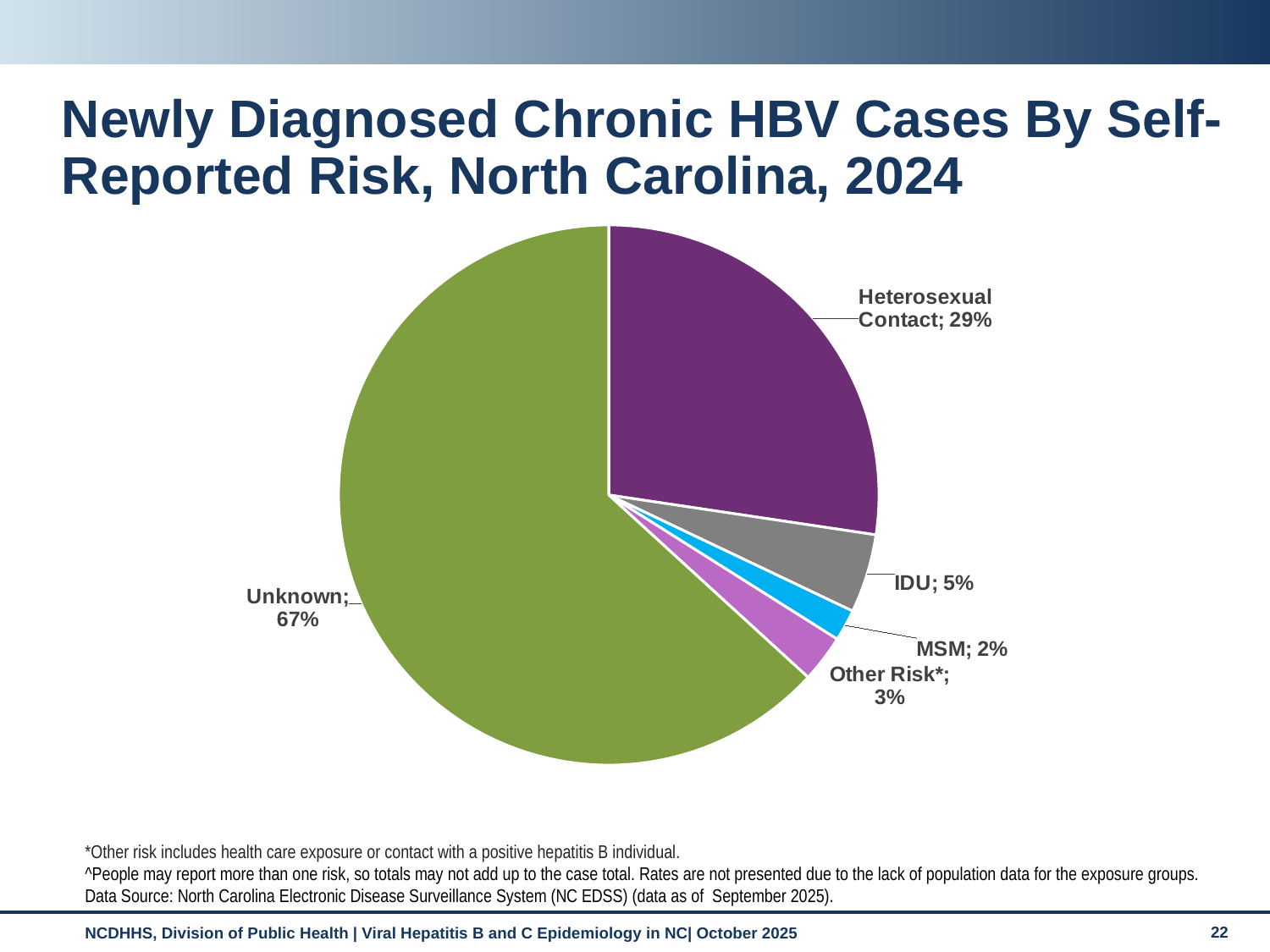
What percentage of cases is attributed to Heterosexual Contact? 29% How many risk categories are shown in the pie chart? 5 What colour is the Unknown slice of the pie? Green What percentage of cases is attributed to Other Risk*? 3% Which risk category has the smallest slice of the pie? MSM Which risk category has the largest slice of the pie? Unknown What share of newly diagnosed chronic HBV cases is labelled Unknown? 67% How many percentage points larger is the Unknown slice than the Heterosexual Contact slice? 38 What type of chart is shown on the slide? Pie chart Which is larger, the IDU slice or the Other Risk* slice? IDU What percentage of cases is attributed to MSM? 2% What percentage of cases is attributed to IDU? 5%